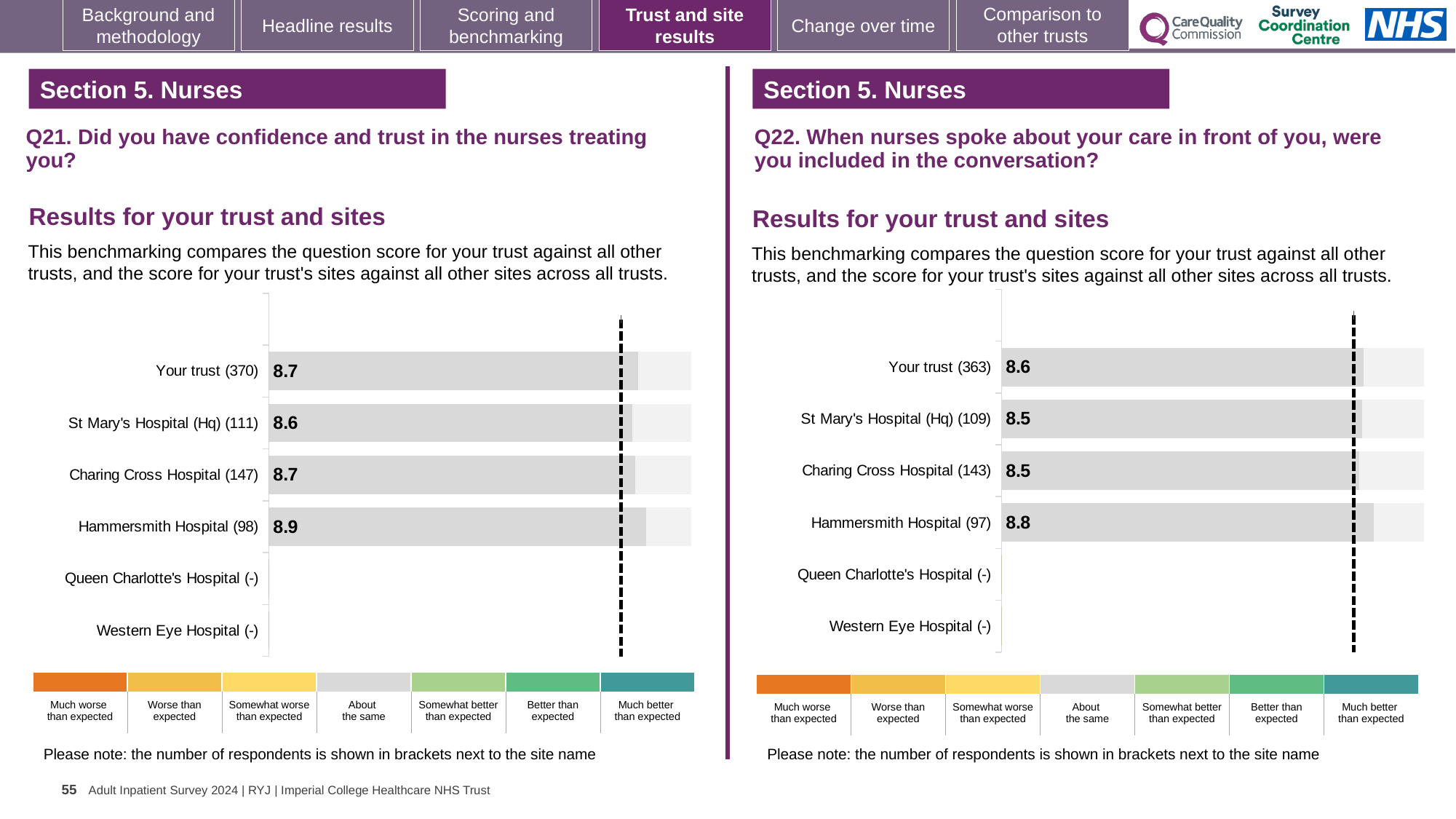
In the Q21 chart on the left, which site has the lowest score among those with a value shown? St Mary's Hospital (Hq) In the Q22 chart on the right, how many sites have a score bar shown? 4 In the Q22 chart on the right, what is the score for Your trust? 8.6 In the Q21 chart on the left, what is the difference between the scores for Hammersmith Hospital and St Mary's Hospital (Hq)? 0.3 In the Q21 chart on the left, which site has the highest score? Hammersmith Hospital In the Q22 chart on the right, what is the score for Charing Cross Hospital? 8.5 In the Q22 chart on the right, what is the difference between the scores for Hammersmith Hospital and Your trust? 0.2 In the Q21 chart on the left, what is the score for Hammersmith Hospital? 8.9 What type of chart is used in the Q21 chart on the left? Bar chart In the Q22 chart on the right, which site has the highest score? Hammersmith Hospital In the Q21 chart on the left, how many respondents are shown in brackets for Charing Cross Hospital? 147 In the Q21 chart on the left, what is the score for Your trust? 8.7